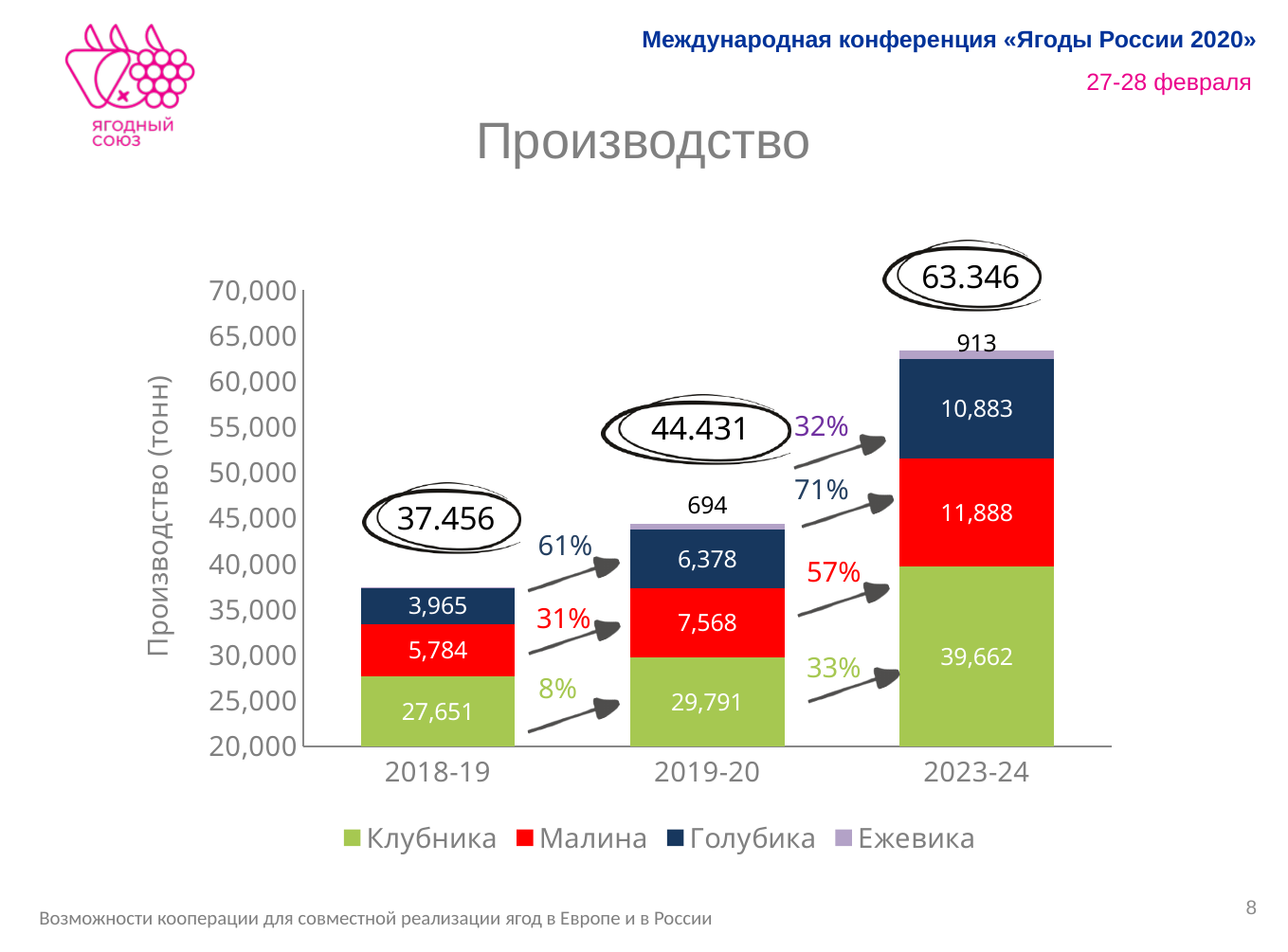
What is the value for Голубика in 2018-19? 3,965 What is the difference between the Клубника values for 2019-20 and 2018-19? 2,140 What is the value for Малина in 2019-20? 7,568 Which is larger in 2023-24, Малина or Голубика? Малина How many series does the legend list? 4 What is the value for Ежевика in 2023-24? 913 What type of chart is shown on the slide? stacked bar chart Which category has the highest total production? 2023-24 Do the total values rise or fall from 2018-19 to 2023-24? rise How many categories are shown on the x axis? 3 What is the value for Клубника in 2023-24? 39,662 What is the total shown for the 2019-20 bar? 44.431